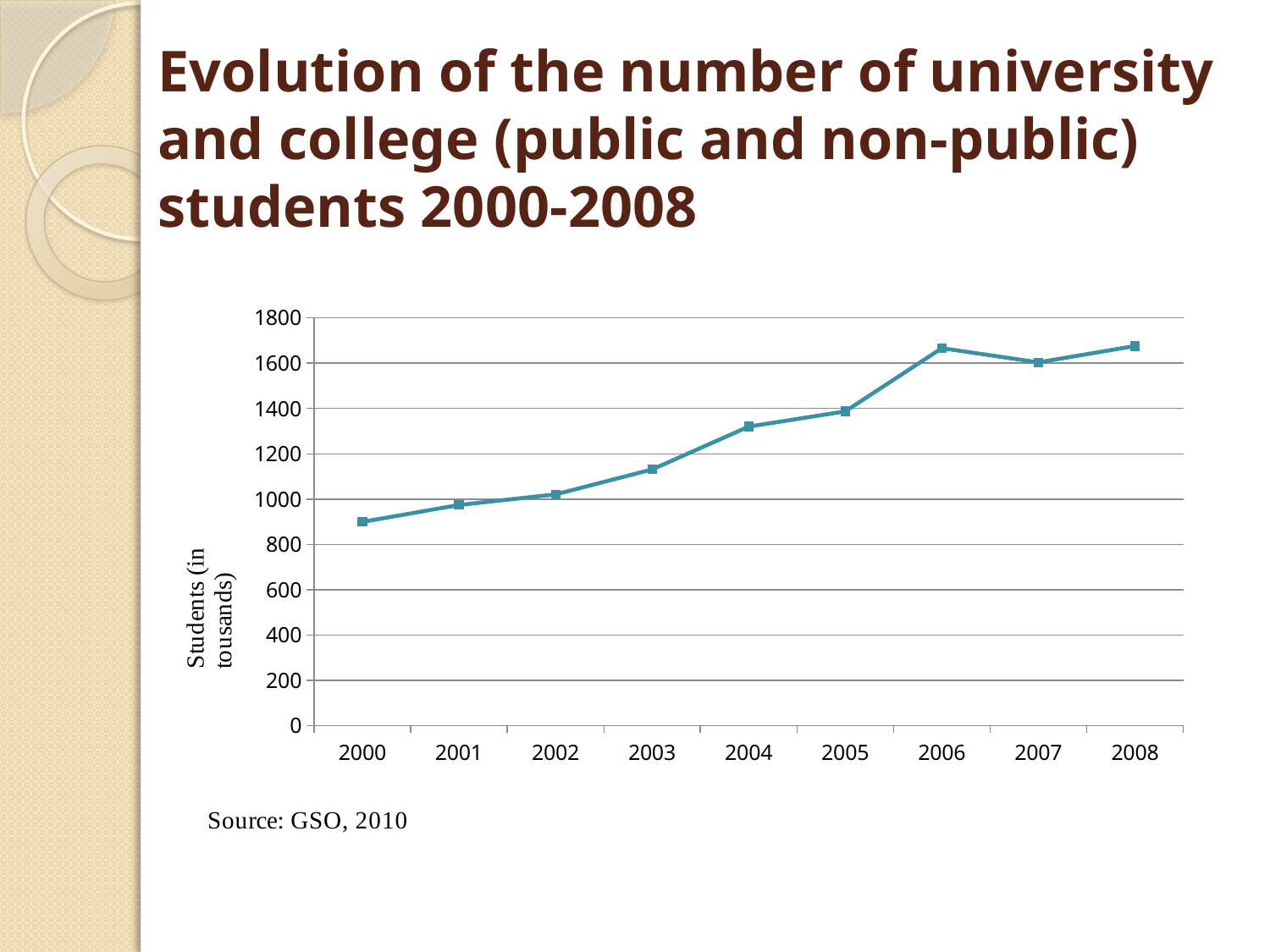
Is the value for 2000 greater or less than 1000? less Which year has the lowest number of students? 2000 Is the value for 2006 greater or less than 1600? greater What kind of chart is shown on the slide? line chart Is the value for 2007 greater or less than 1800? less Do the values generally rise or fall from 2000 to 2008? rise What is the label on the y axis? Students (in tousands) How many years are plotted on the x axis? 9 Which year has the larger value, 2006 or 2007? 2006 Which year has the larger value, 2003 or 2004? 2004